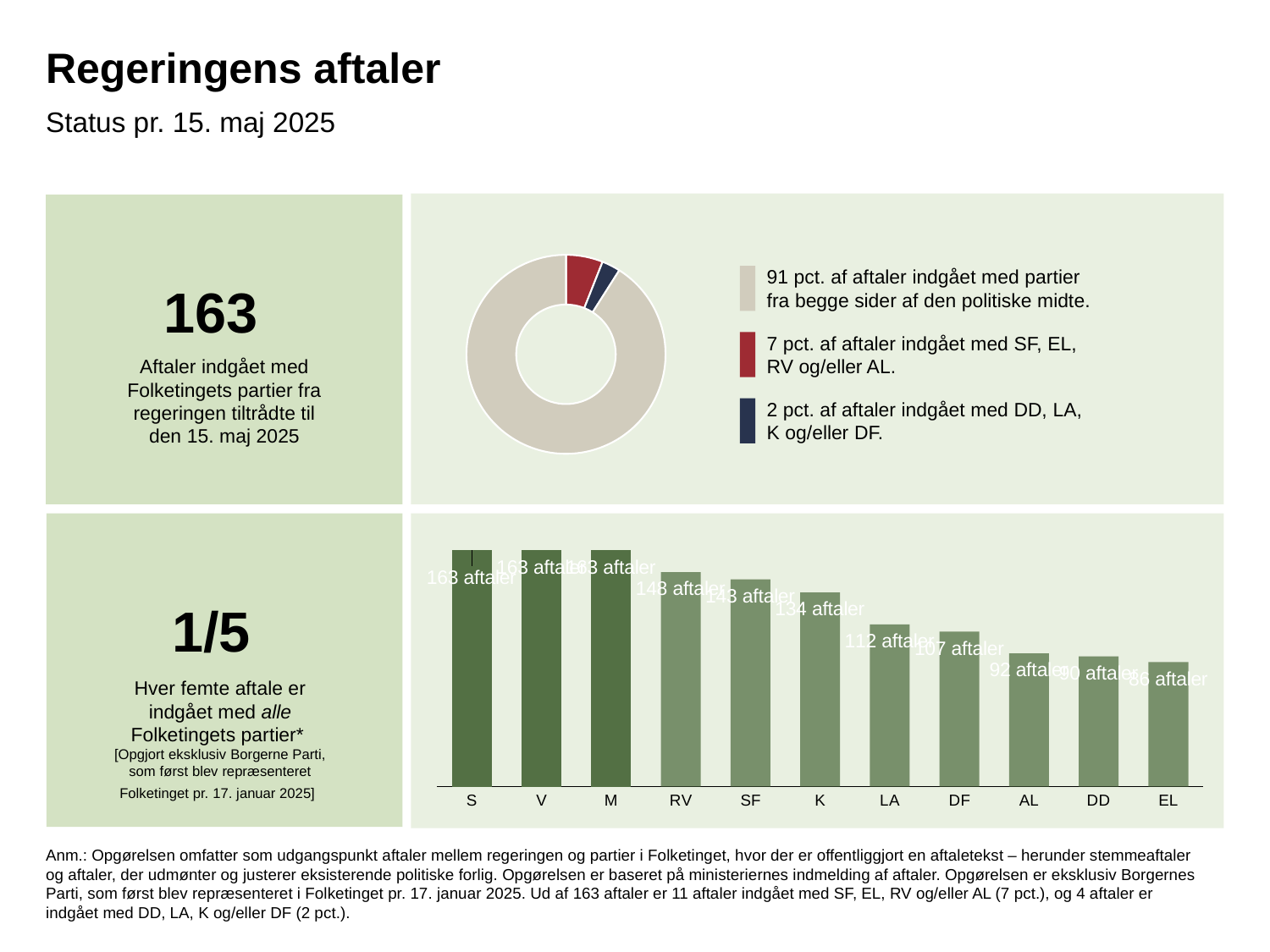
What kind of chart is shown at the bottom right of the slide? Bar chart How many parties are shown on the x axis of the bar chart at the bottom right? 11 In the donut chart at the top right, what share of agreements was made with parties from both sides of the political centre? 91 pct. In the bar chart at the bottom right, which is larger, the value for SF or the value for LA? SF In the bar chart at the bottom right, do the values rise or fall from S to EL along the x axis? Fall In the bar chart at the bottom right, what is the difference between the values for S and AL? 71 aftaler In the bar chart at the bottom right, what is the value for K? 134 aftaler In the bar chart at the bottom right, which party has the lowest value? EL In the donut chart at the top right, what share of agreements was made with SF, EL, RV og/eller AL? 7 pct. In the bar chart at the bottom right, what is the value for EL? 86 aftaler In the bar chart at the bottom right, what is the difference between the values for RV and DF? 41 aftaler In the bar chart at the bottom right, what is the value for LA? 112 aftaler